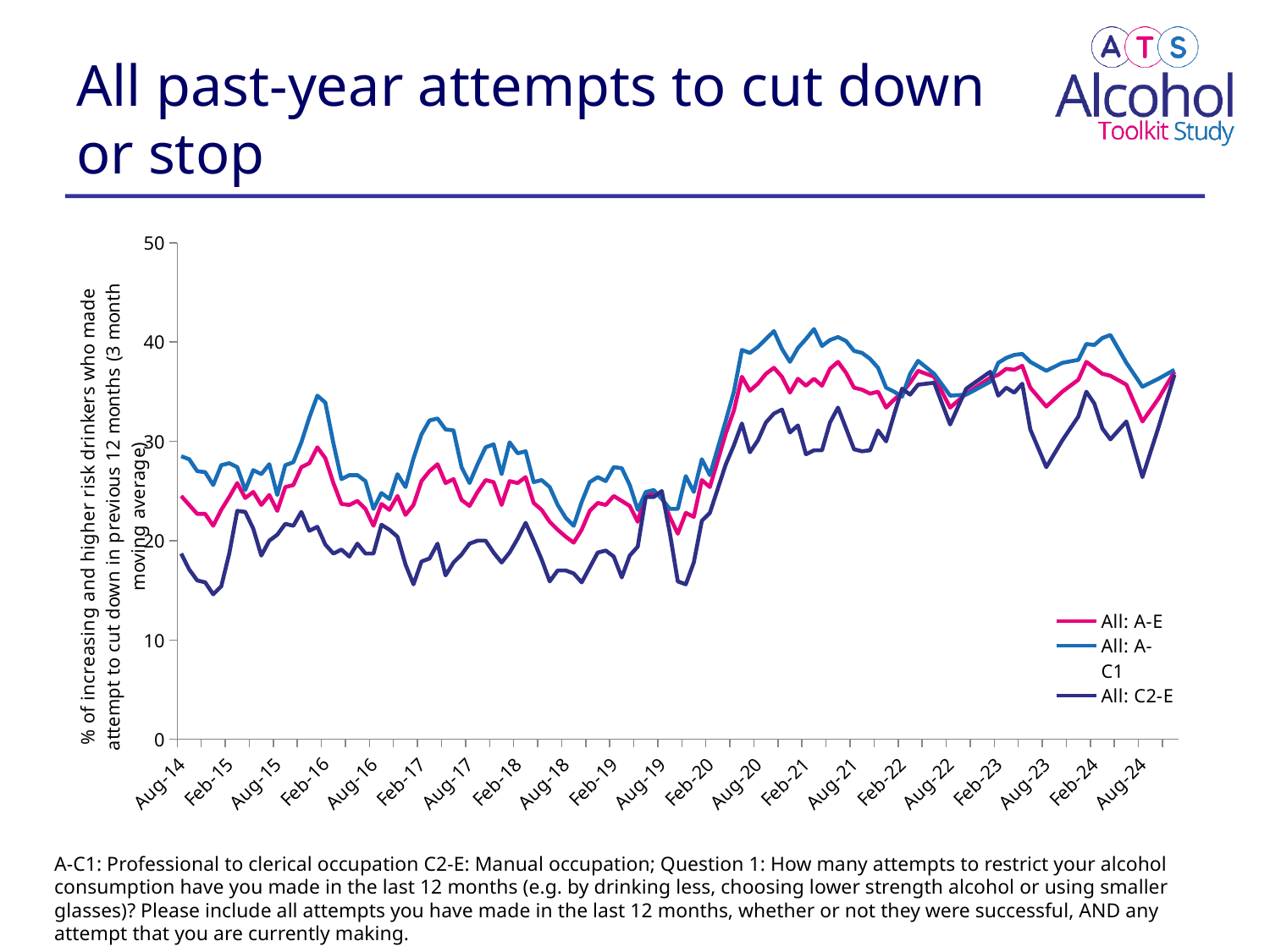
Which series has the lowest value at Feb-21? All: C2-E Is the value for All: C2-E at Feb-15 greater or less than 20? less How many date labels are shown along the x axis? 21 How many series does the legend list? 3 Does the All: C2-E series rise or fall between Feb-20 and Aug-20? rise Is the value for All: C2-E at Feb-20 greater or less than 20? greater What is the highest value shown on the y axis? 50 Is the value for All: A-C1 at Feb-16 greater or less than 30? greater What kind of chart is shown on the slide? line chart At Aug-14, which series has the larger value, All: A-C1 or All: C2-E? All: A-C1 What are the three series named in the legend? All: A-E, All: A-C1, All: C2-E